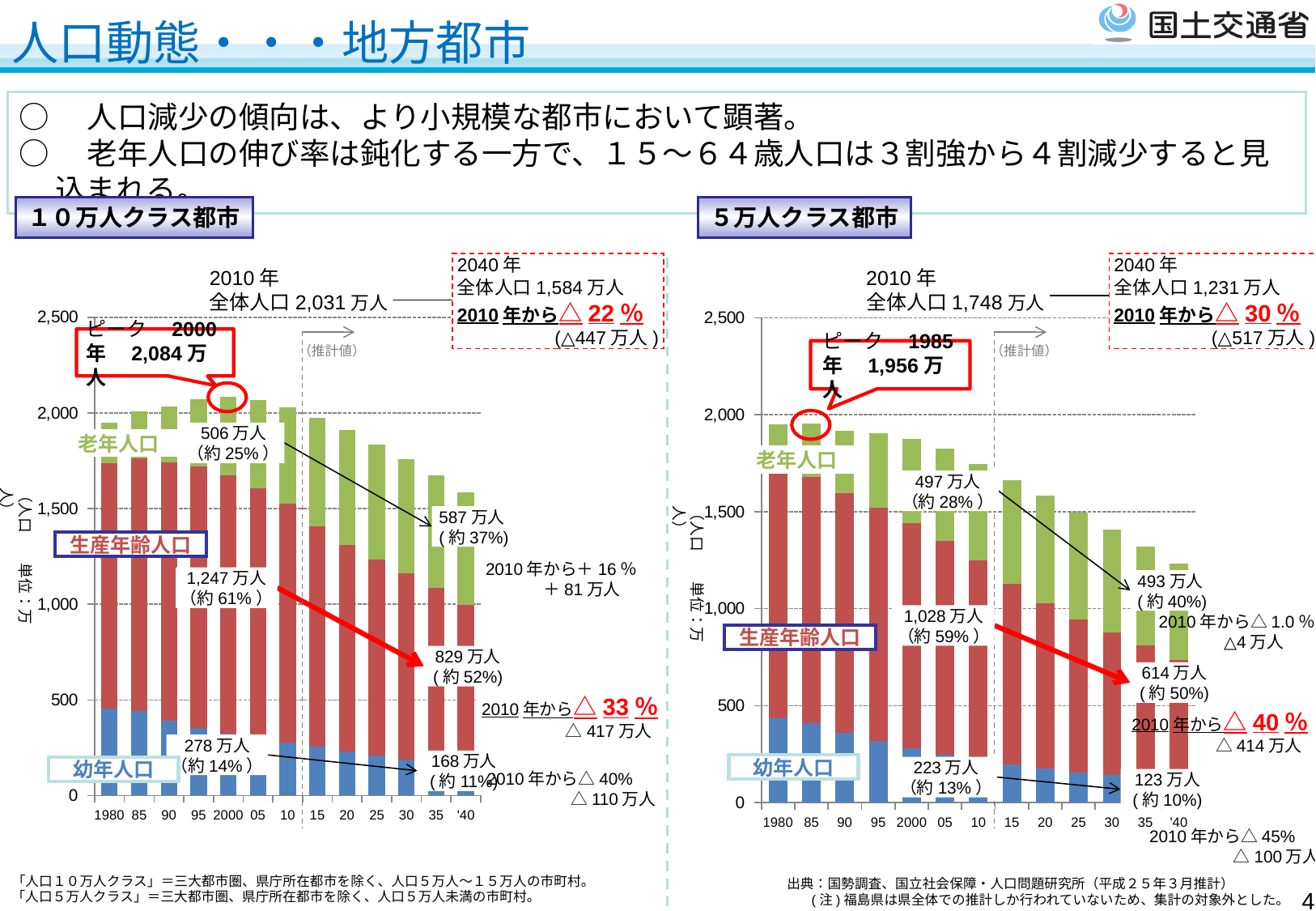
What type of chart is used on the slide for the 10万人クラス都市 population data? Stacked bar chart In the 5万人クラス都市 chart, what is the 幼年人口 value labelled for 2010? 223万人 In the 5万人クラス都市 chart, does the total population rise or fall from 2010 to 2040? fall In the 10万人クラス都市 chart, what share of the 2010 population is 老年人口? 約25% In the 5万人クラス都市 chart, is the total population bar for 2040 greater or less than 1,500? less In the 10万人クラス都市 chart, what is the 生産年齢人口 value labelled for 2040? 829万人 How many population series (segments) are stacked in each bar of the 10万人クラス都市 chart? 3 In the 5万人クラス都市 chart, what is the difference between the total population in 2010 and in 2040? 517万人 In the 10万人クラス都市 chart, what is the total population shown for 2010? 2,031万人 How many year categories are shown on the x axis of the 5万人クラス都市 chart? 13 In the 10万人クラス都市 chart, which is larger: the 老年人口 in 2010 or the 老年人口 in 2040? 2040 (587万人) In the 5万人クラス都市 chart, what is the peak population value and in which year does it occur? 1,956万人 in 1985